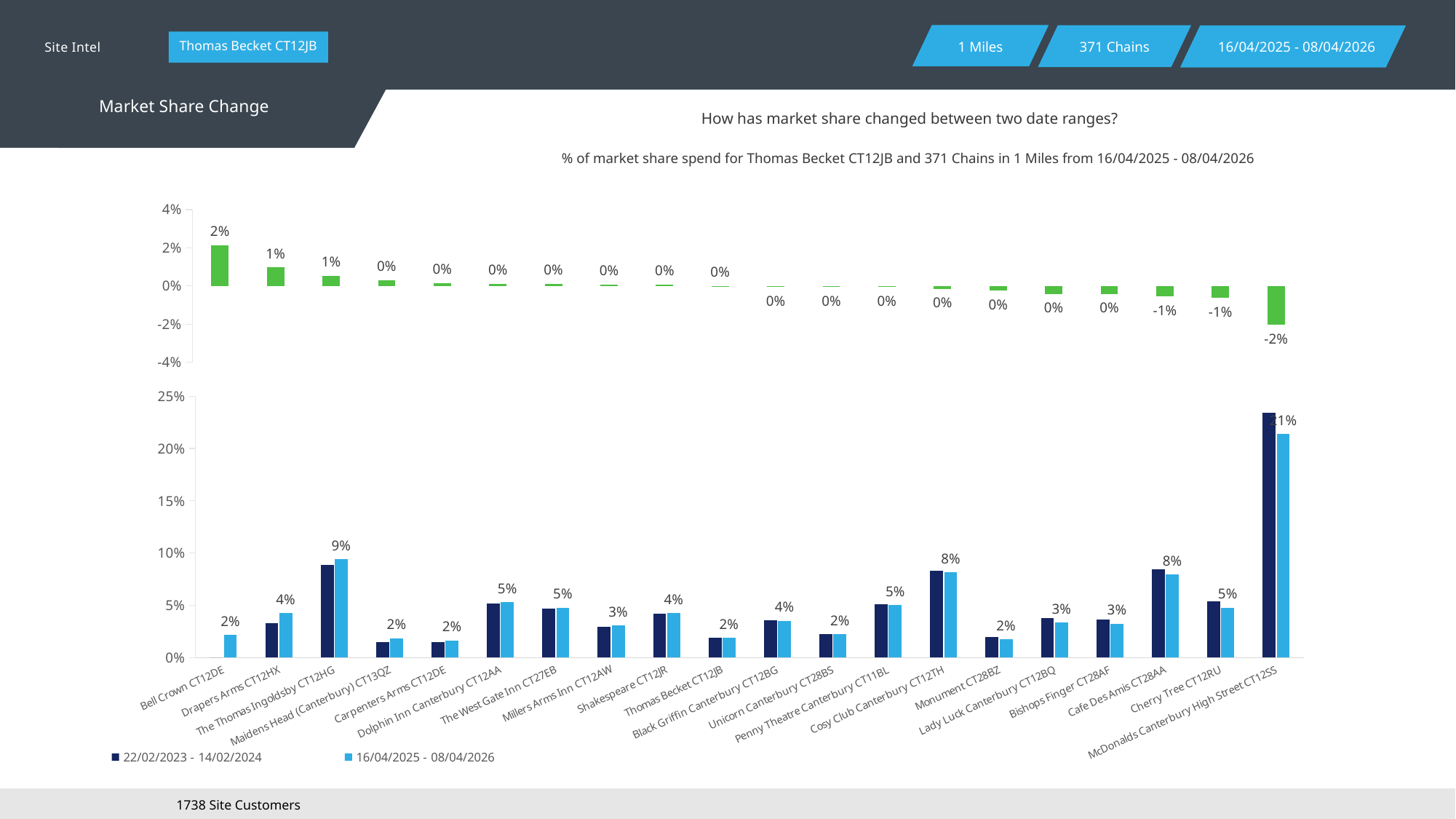
In the bottom chart, which category has the highest market share in the 16/04/2025 - 08/04/2026 series? McDonalds Canterbury High Street CT12SS In the top chart, what is the market share change for McDonalds Canterbury High Street CT12SS? -2% In the top chart, what is the market share change for Bell Crown CT12DE? 2% How many categories are shown on the x axis of the bottom chart? 20 In the bottom chart, what is the difference between the 16/04/2025 - 08/04/2026 values for McDonalds Canterbury High Street CT12SS and The Thomas Ingoldsby CT12HG? 12% How many series does the legend of the bottom chart list? 2 In the bottom chart, is the value for McDonalds Canterbury High Street CT12SS in the 22/02/2023 - 14/02/2024 series greater or less than 20%? greater In the top chart, what is the market share change for Cafe Des Amis CT28AA? -1% In the top chart, which category has the lowest market share change? McDonalds Canterbury High Street CT12SS In the bottom chart, what is the market share for The Thomas Ingoldsby CT12HG in the 16/04/2025 - 08/04/2026 series? 9% In the top chart, which category has the highest market share change? Bell Crown CT12DE What kind of chart is the top chart showing market share change? bar chart